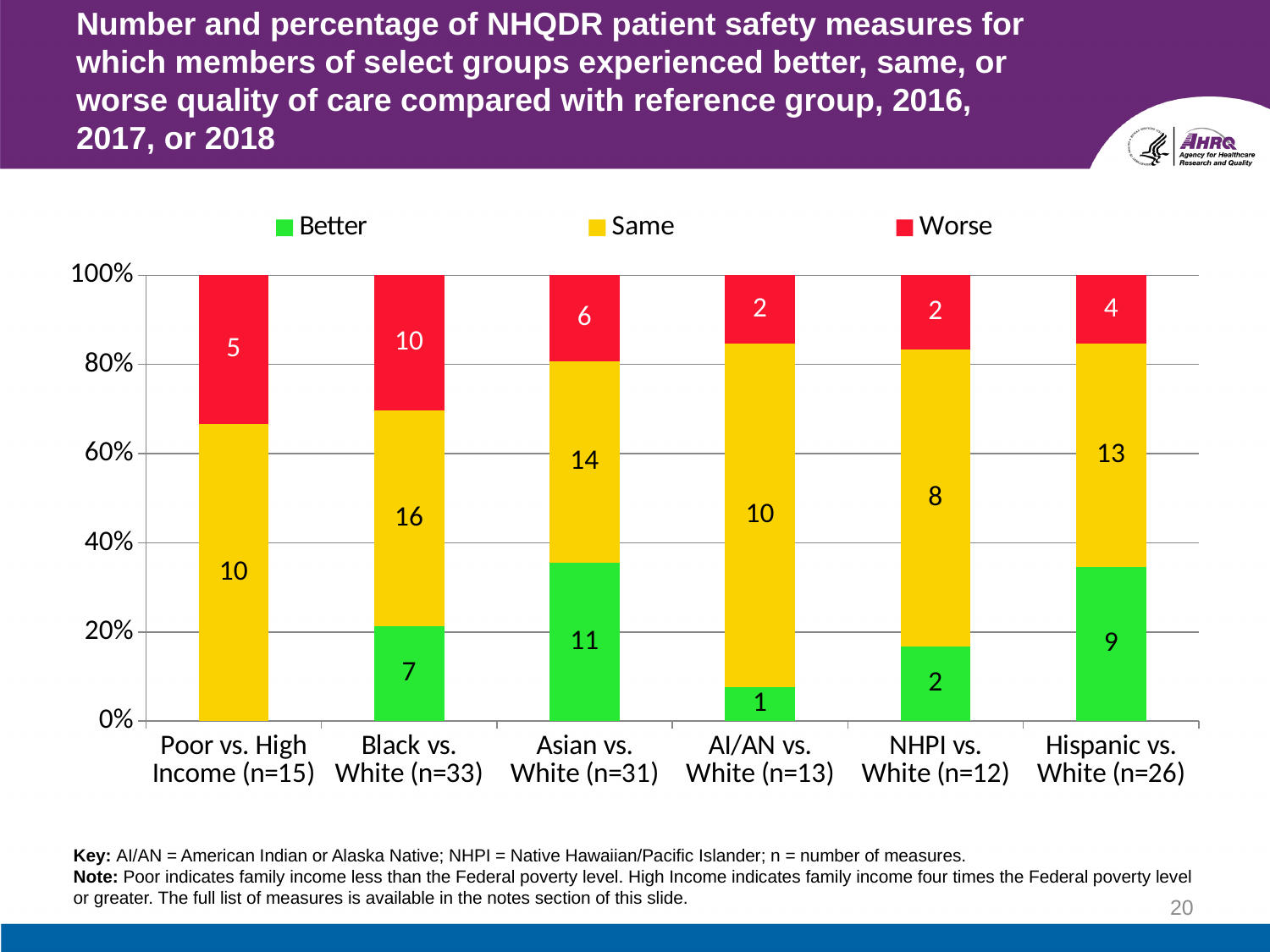
What is the difference between the "Same" and "Better" counts for Hispanic vs. White (n=26)? 4 Which group has the highest number of "Worse" measures? Black vs. White (n=33) What is the total number of measures in the bar for NHPI vs. White (n=12)? 12 How many comparison groups are shown on the x axis? 6 Which is larger: the "Worse" count for Poor vs. High Income (n=15) or the "Worse" count for Hispanic vs. White (n=26)? Poor vs. High Income (n=15) What is the number of "Worse" measures for Asian vs. White (n=31)? 6 What kind of chart is shown on the slide? Stacked bar chart How many "Better" measures are shown for AI/AN vs. White (n=13)? 1 Is the top of the "Same" segment for Poor vs. High Income (n=15) greater or less than 60%? greater Which group has the highest number of "Better" measures? Asian vs. White (n=31) How many measures are labeled "Same" for Black vs. White (n=33)? 16 How many series does the legend list? 3